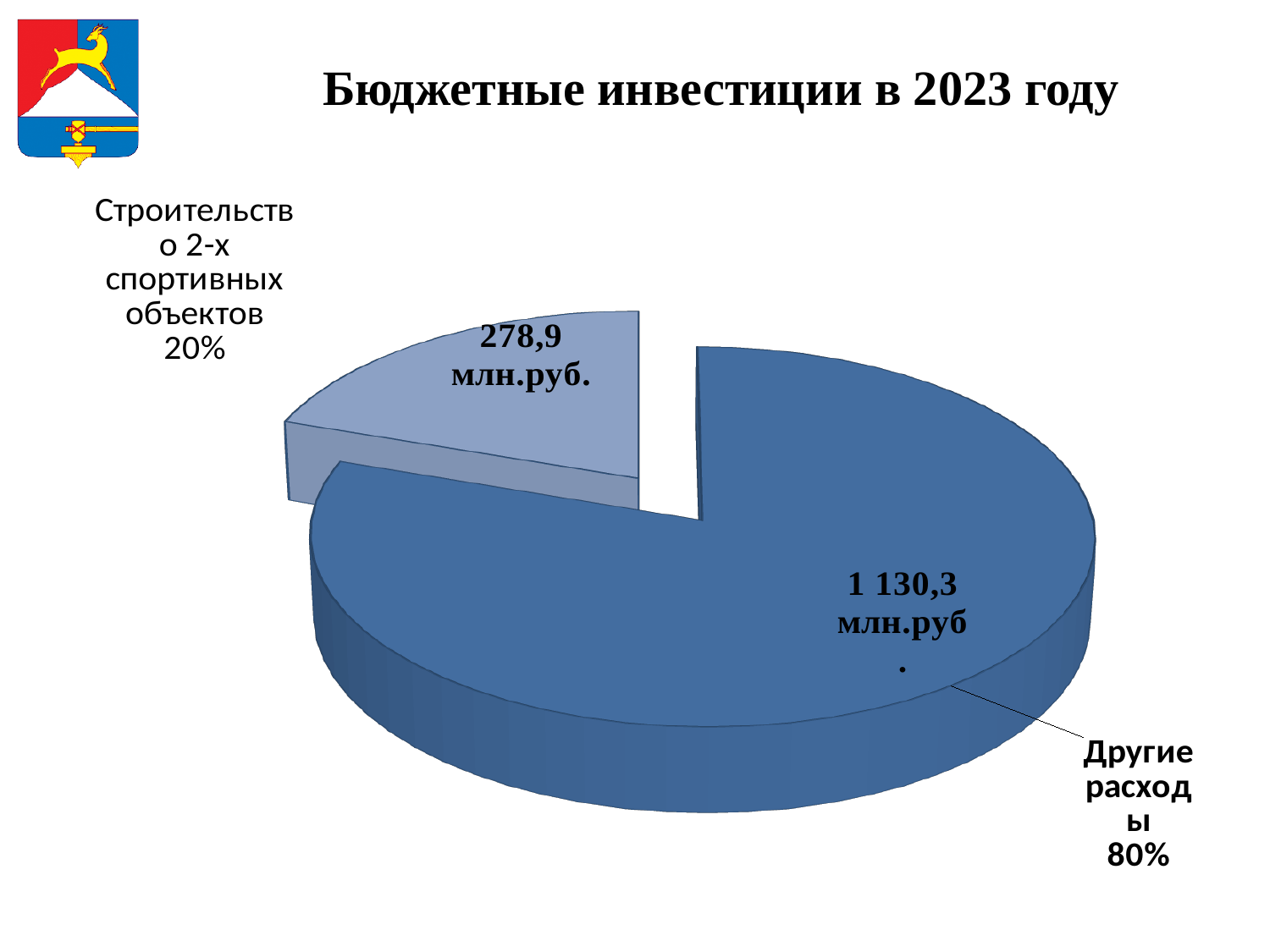
What is the total of the two slices in the pie chart? 1 409,2 млн.руб. What share of the pie does Строительство 2-х спортивных объектов represent? 20% How many slices does the pie chart have? 2 What is the title of the chart? Бюджетные инвестиции в 2023 году What is the difference between Другие расходы and Строительство 2-х спортивных объектов? 851,4 млн.руб. What is the value for Строительство 2-х спортивных объектов? 278,9 млн.руб. What is the value for Другие расходы? 1 130,3 млн.руб. What share of the pie does Другие расходы represent? 80% Which is larger: Другие расходы or Строительство 2-х спортивных объектов? Другие расходы Which slice is the largest? Другие расходы What kind of chart is shown on the slide? Pie chart Which slice is the smallest? Строительство 2-х спортивных объектов